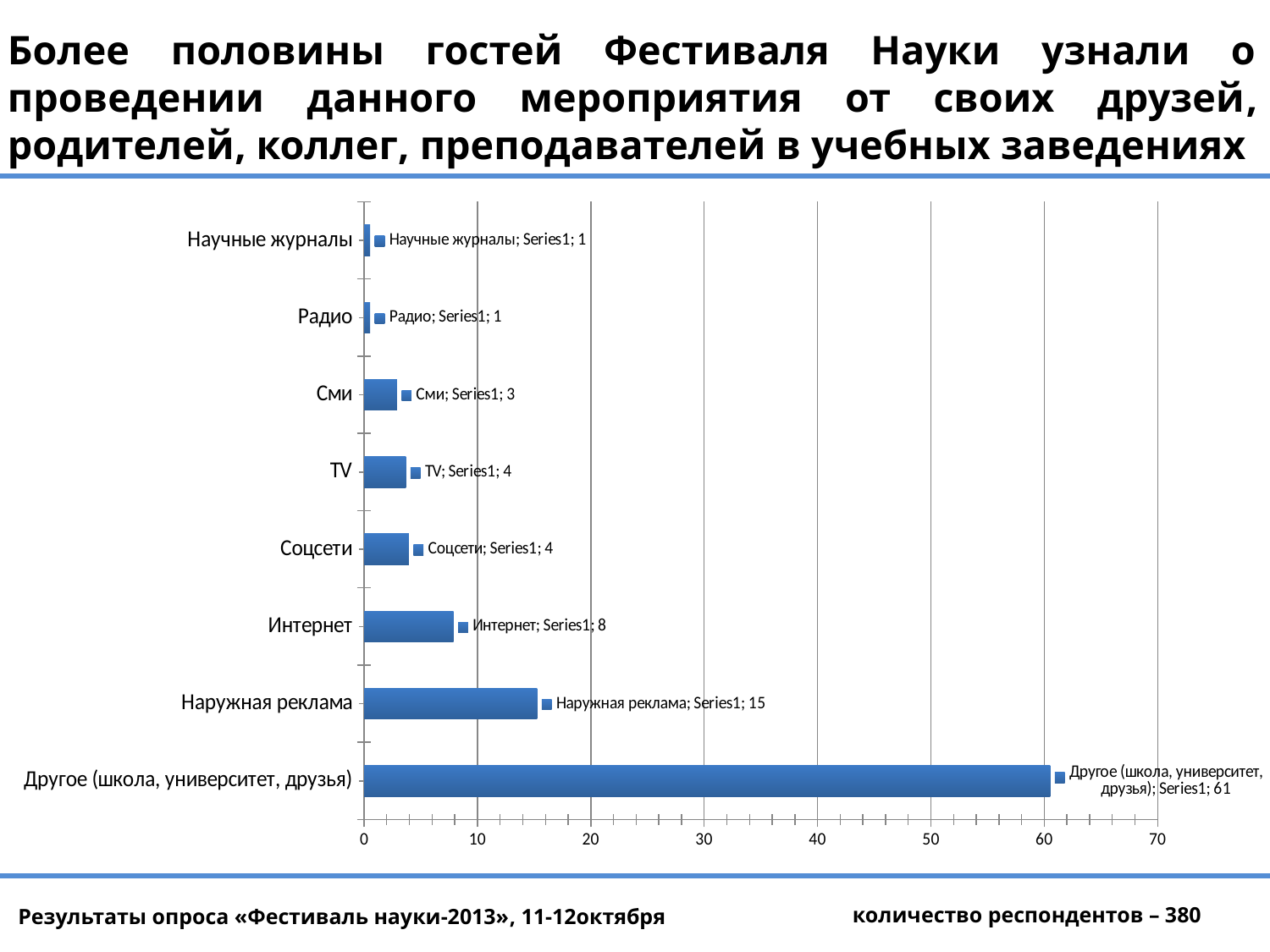
What is the value for Наружная реклама? 15 What is the value for Интернет? 8 Is the value for Другое (школа, университет, друзья) greater or less than 50? greater What kind of chart is shown on the slide? bar chart What is the value for Другое (школа, университет, друзья)? 61 How many categories are shown on the chart? 8 What is the value for Сми? 3 Which category has the highest value? Другое (школа, университет, друзья) Which is larger, the value for Наружная реклама or the value for Интернет? Наружная реклама What is the number of respondents stated at the bottom of the slide? 380 What is the difference between the values for Интернет and TV? 4 What is the difference between the values for Другое (школа, университет, друзья) and Наружная реклама? 46